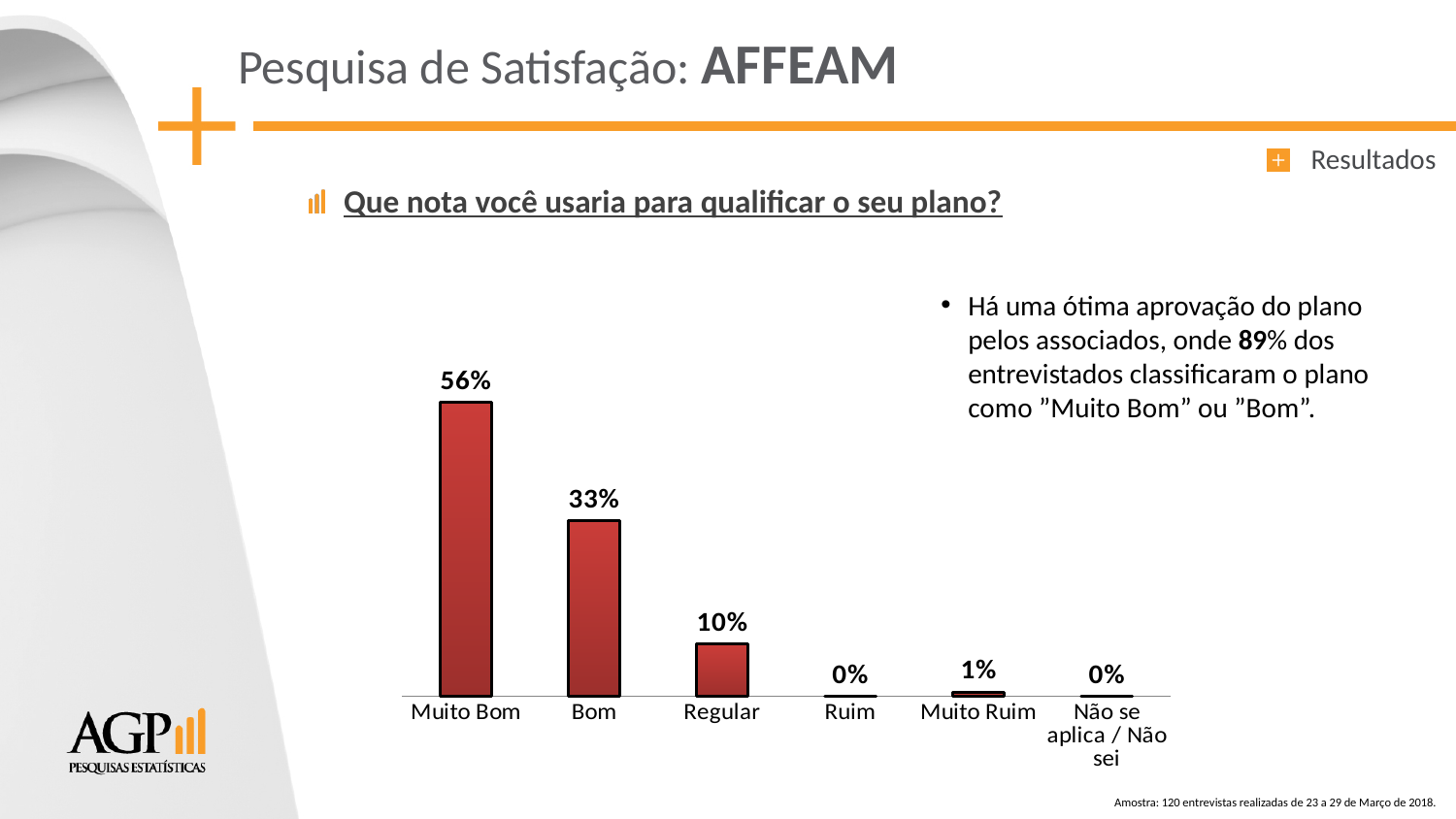
What kind of chart is shown on the slide? Bar chart What is the value for Ruim? 0% What is the difference between the values for Muito Bom and Bom? 23% What is the value for Bom? 33% What question does the chart answer, as written above it? Que nota você usaria para qualificar o seu plano? What is the value for Regular? 10% What is the difference between the values for Bom and Regular? 23% What is the value for Muito Ruim? 1% Which is larger, the value for Regular or the value for Muito Ruim? Regular Which category has the highest value? Muito Bom What is the value for Muito Bom? 56% How many categories are shown on the x axis? 6